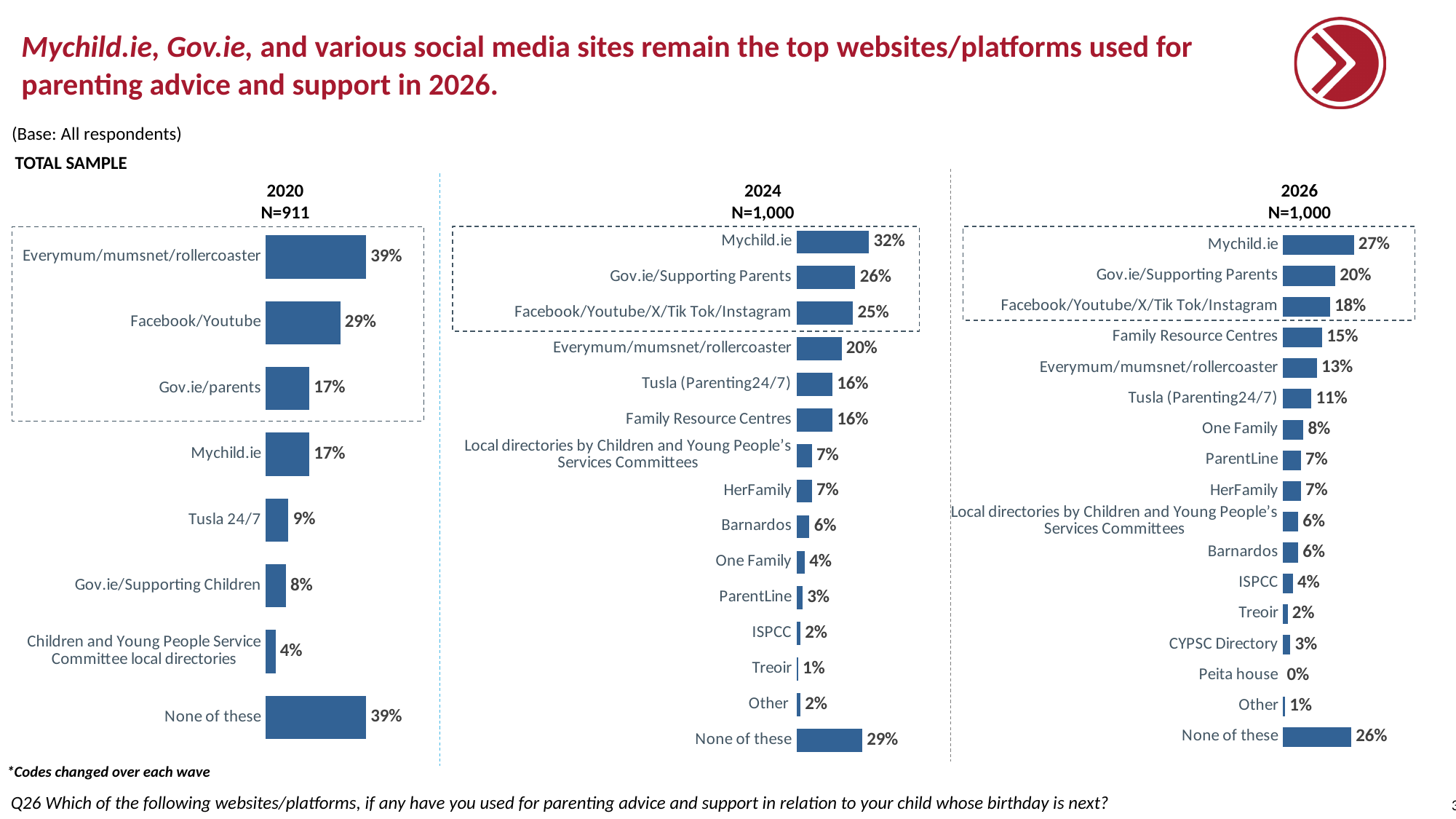
In the 2026 chart, what percentage is shown for Family Resource Centres? 15% In the 2020 chart, what percentage is shown for None of these? 39% How many categories are shown in the 2020 chart? 8 What type of chart is used to show the 2024 data? Bar chart In the 2026 chart, which category has the lowest percentage? Peita house In the 2020 chart, what percentage is shown for Facebook/Youtube? 29% In the 2026 chart, what percentage is shown for Mychild.ie? 27% In the 2024 chart, what percentage is shown for Gov.ie/Supporting Parents? 26% In the 2024 chart, which is larger: Everymum/mumsnet/rollercoaster or Tusla (Parenting24/7)? Everymum/mumsnet/rollercoaster In the 2026 chart, what is the difference between Mychild.ie and Gov.ie/Supporting Parents? 7 percentage points In the 2024 chart, which website/platform has the highest percentage? Mychild.ie What is the sample size (N) shown for the 2020 chart? N=911